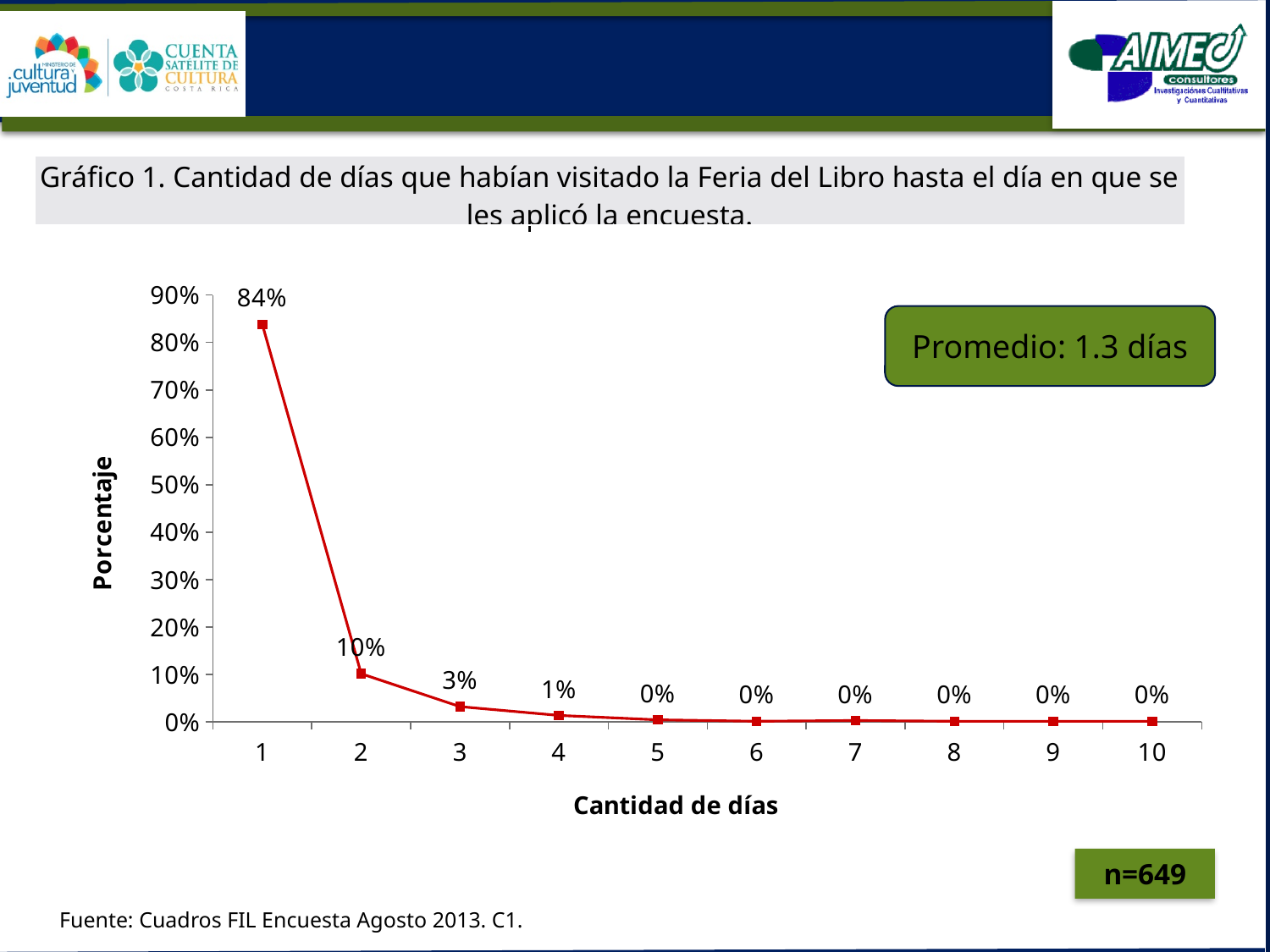
What kind of chart is shown on the slide? line chart Which number of days has the highest percentage? 1 Is the value for 1 day greater or less than 80%? greater What is the value for 3 days? 3% What percentage of respondents had visited the Feria del Libro for 1 day? 84% Do the values rise or fall as the number of days increases along the x axis? fall How many points (categories on the x axis) are plotted in the chart? 10 What is the value for 4 days? 1% What is the value for 2 days (Cantidad de días = 2)? 10% What is the difference between the percentage for 1 day and the percentage for 2 days? 74% Which is larger, the value for 2 days or the value for 3 days? 2 days What is the label of the y axis of the chart? Porcentaje